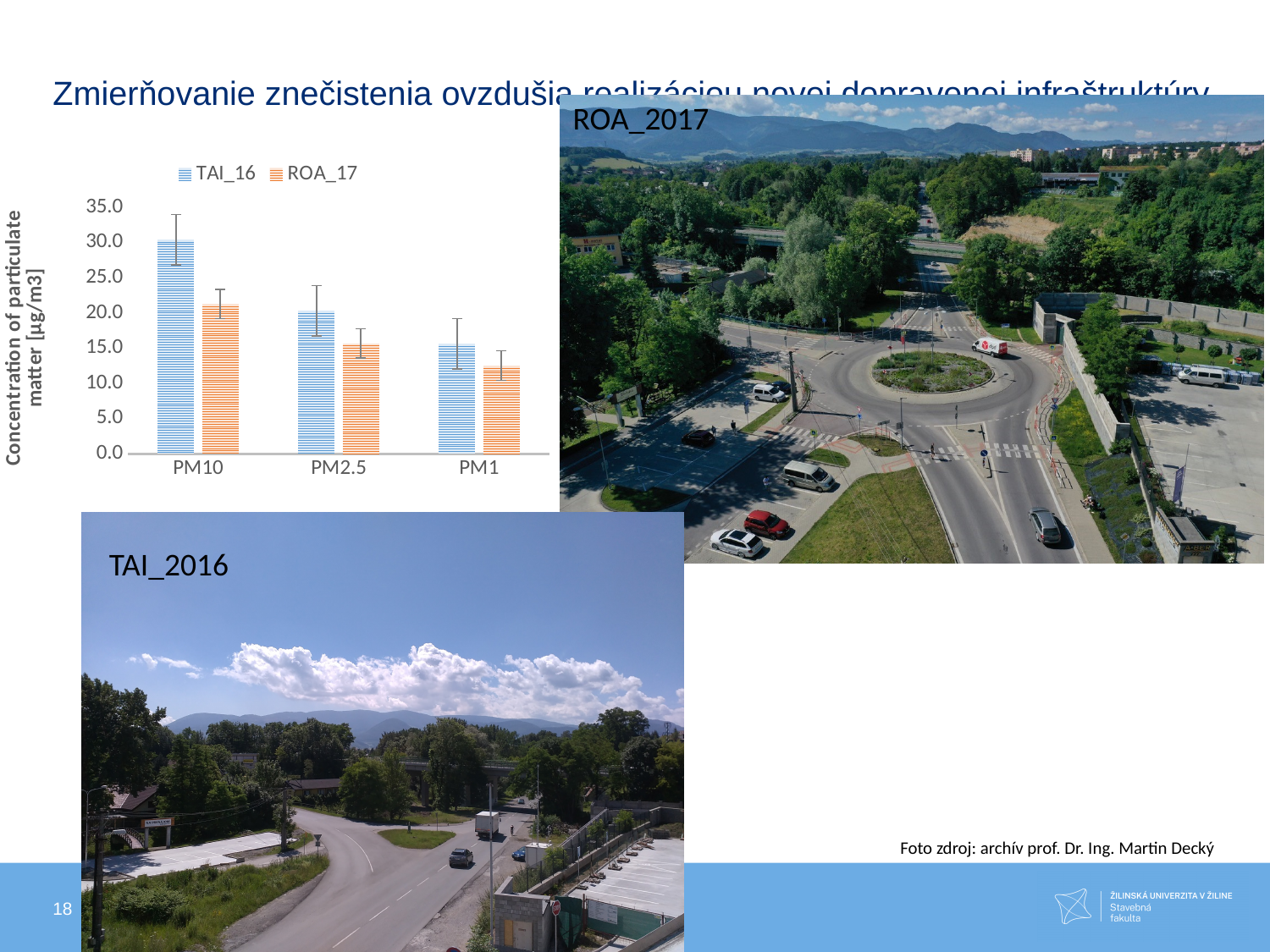
Which category has the highest TAI_16 value? PM10 How many categories are shown on the x axis of the chart? 3 Is the TAI_16 value for PM10 greater or less than 25.0? greater Is the ROA_17 value for PM10 greater or less than 25.0? less How many series does the chart legend list? 2 Which category has the lowest ROA_17 value? PM1 What is the label of the chart's vertical axis? Concentration of particulate matter [µg/m3] For PM10, which series has the larger value, TAI_16 or ROA_17? TAI_16 Is the ROA_17 value for PM1 greater or less than 15.0? less What kind of chart is shown on the slide? bar chart For PM2.5, which series has the larger value, TAI_16 or ROA_17? TAI_16 Do the TAI_16 values rise or fall going from PM10 to PM1 along the x axis? fall